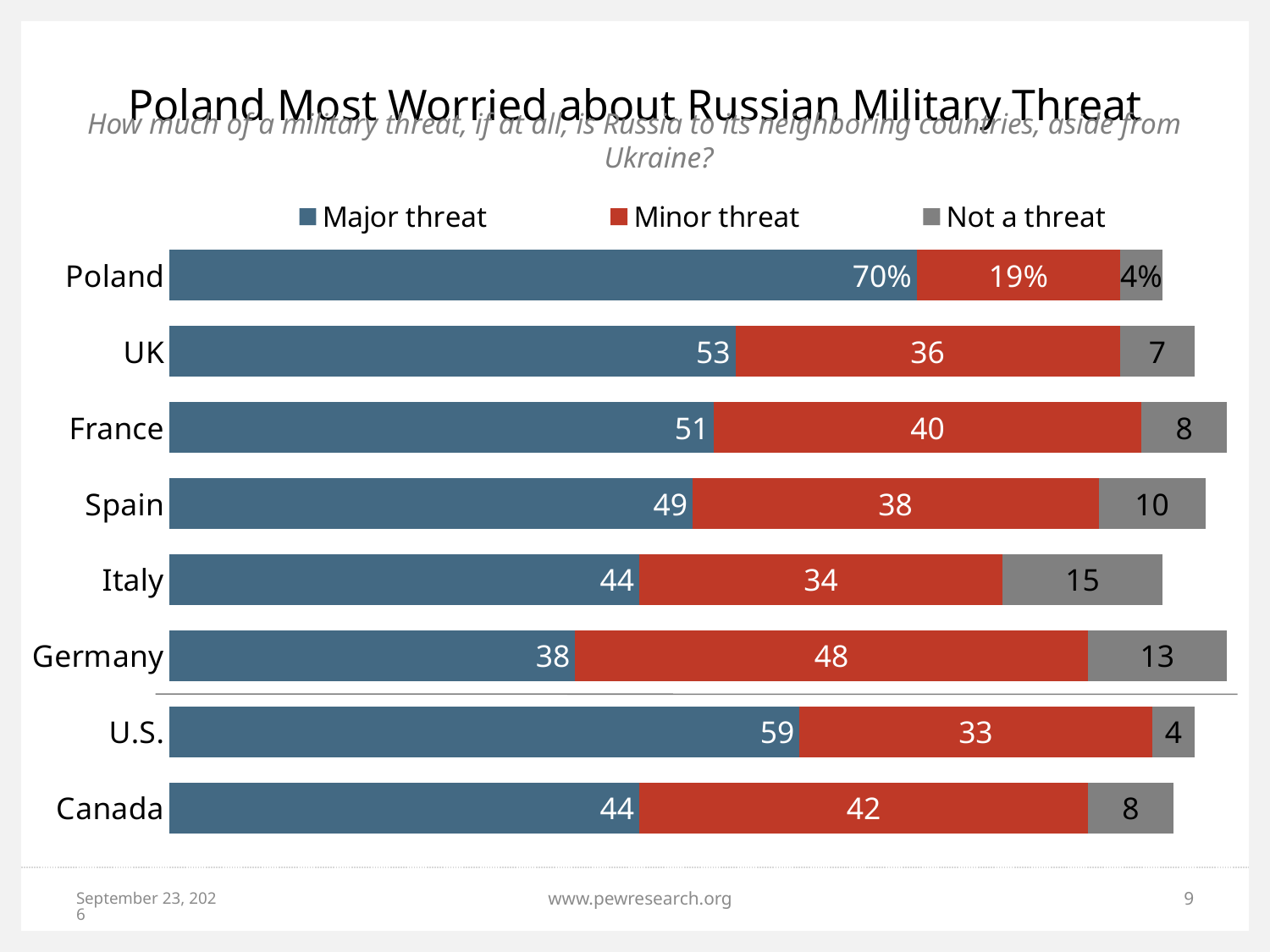
What is the Not a threat value for Italy? 15 What percentage of respondents in Poland say Russia is a major threat? 70% Which colour represents the Not a threat series in the chart? Gray What is the total of the three values shown for the UK bar? 96 What is the difference between the Major threat values for Poland and the U.S.? 11 How many series does the legend list? 3 Which is larger, the Minor threat value for France or for Spain? France What is the Minor threat value for Germany? 48 Which country has the highest Major threat value? Poland What kind of chart is shown on the slide? Stacked bar chart How many countries are shown in the chart? 8 Which country has the lowest Major threat value? Germany